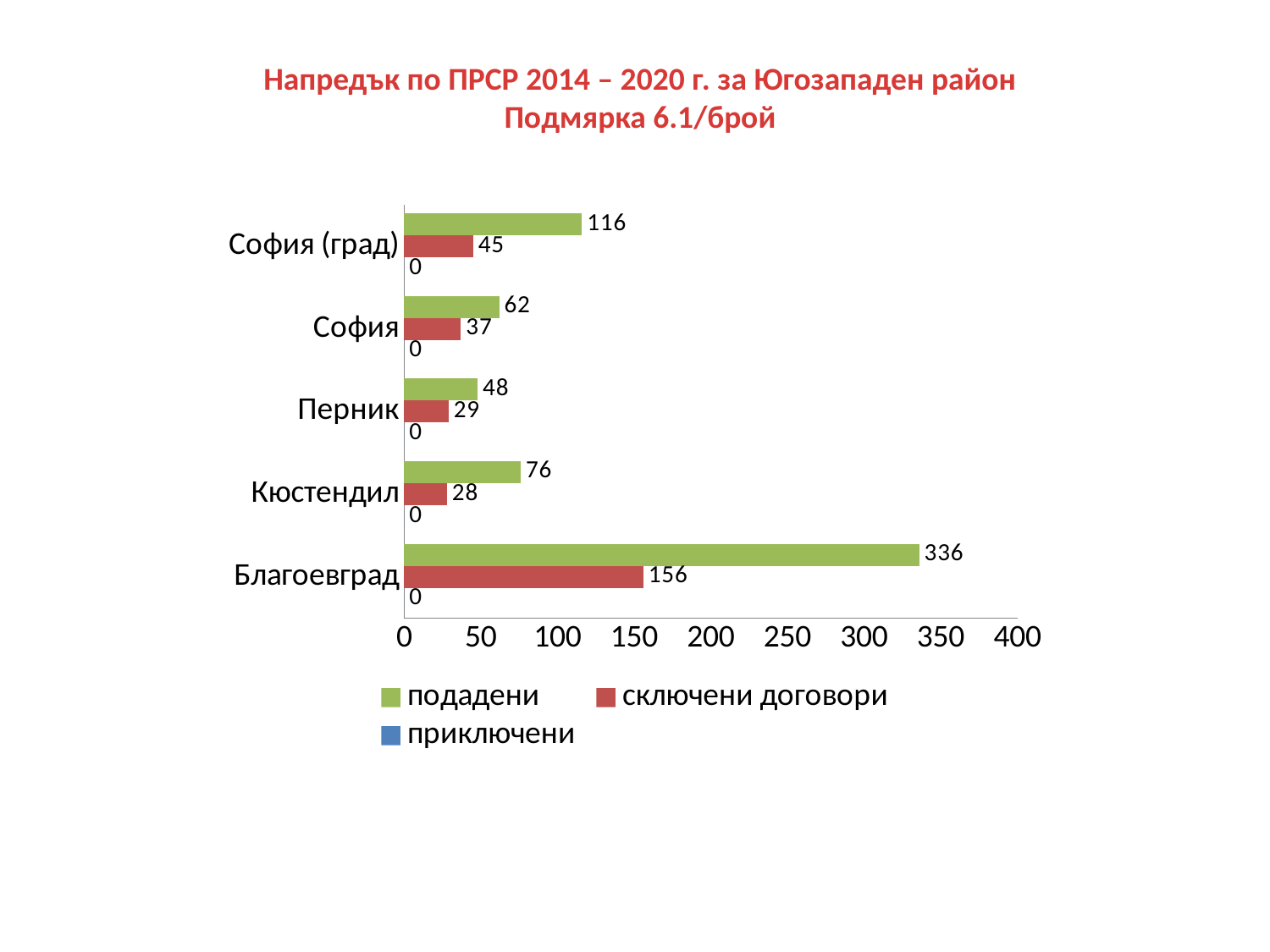
Which category has the highest value for "подадени"? Благоевград What is the difference between "подадени" and "сключени договори" for Благоевград? 180 What is the value of "сключени договори" for София (град)? 45 Which colour represents the "сключени договори" series? red How many series does the legend list? 3 What is the value of "подадени" for Перник? 48 What is the value of "приключени" for Кюстендил? 0 What kind of chart is shown on the slide? bar chart Which is larger: "подадени" for Кюстендил or "подадени" for София? Кюстендил How many categories are shown on the chart? 5 Which category has the lowest value for "сключени договори"? Кюстендил What is the value of "подадени" for Благоевград? 336